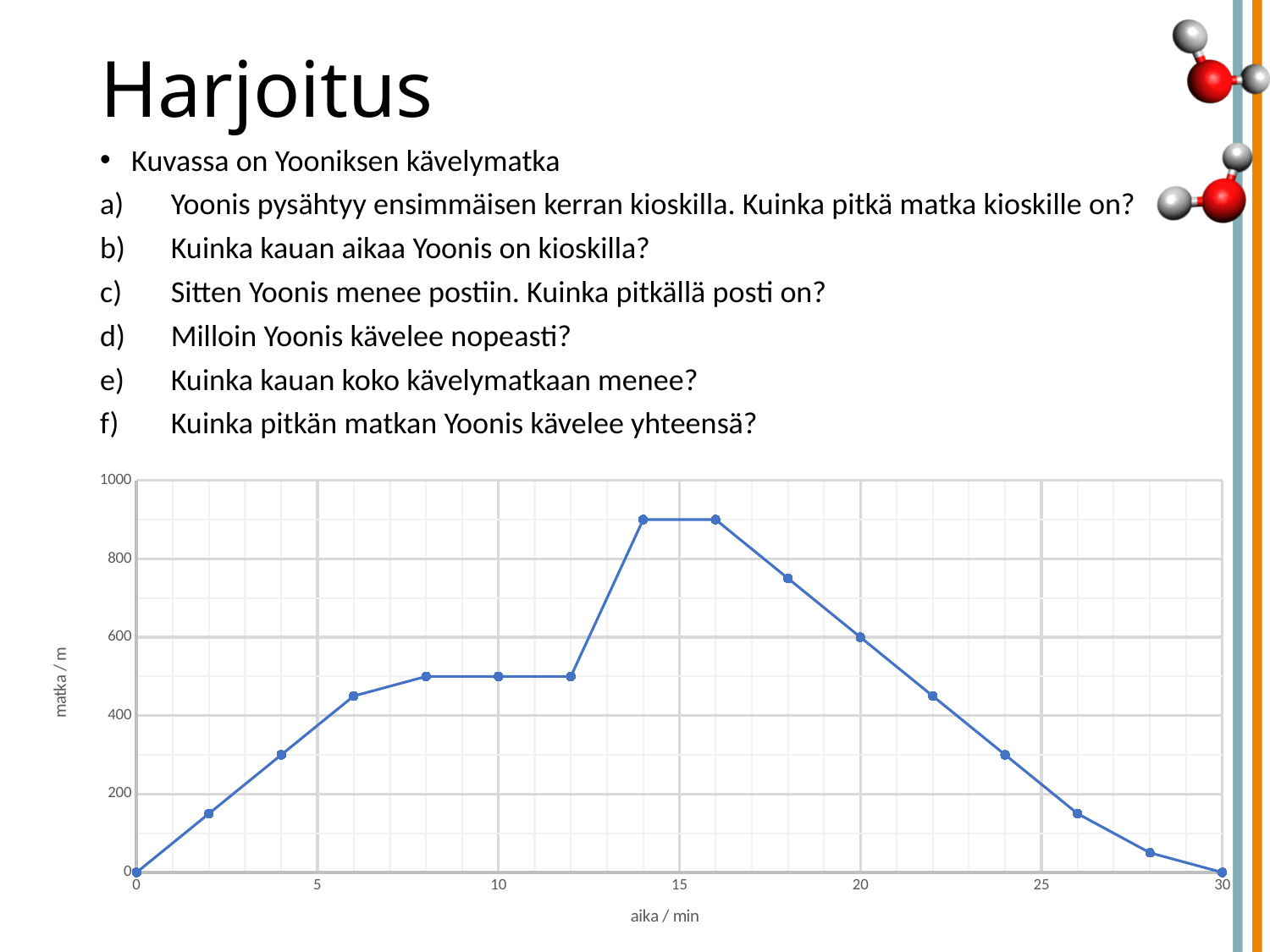
What is the value of matka / m at 20 min? 600 What is the title of the y axis of the chart? matka / m Is the value at 14 min greater or less than 800? greater What is the value of matka / m at 30 min? 0 Does the distance rise or fall along the x axis between 16 min and 30 min? fall Is the value at 10 min greater or less than 400? greater What is the title of the x axis of the chart? aika / min What kind of chart is shown on the slide? line chart Which is larger, the value at 10 min or the value at 20 min? 20 min Is the value at 28 min greater or less than 200? less How many data points are plotted on the line? 16